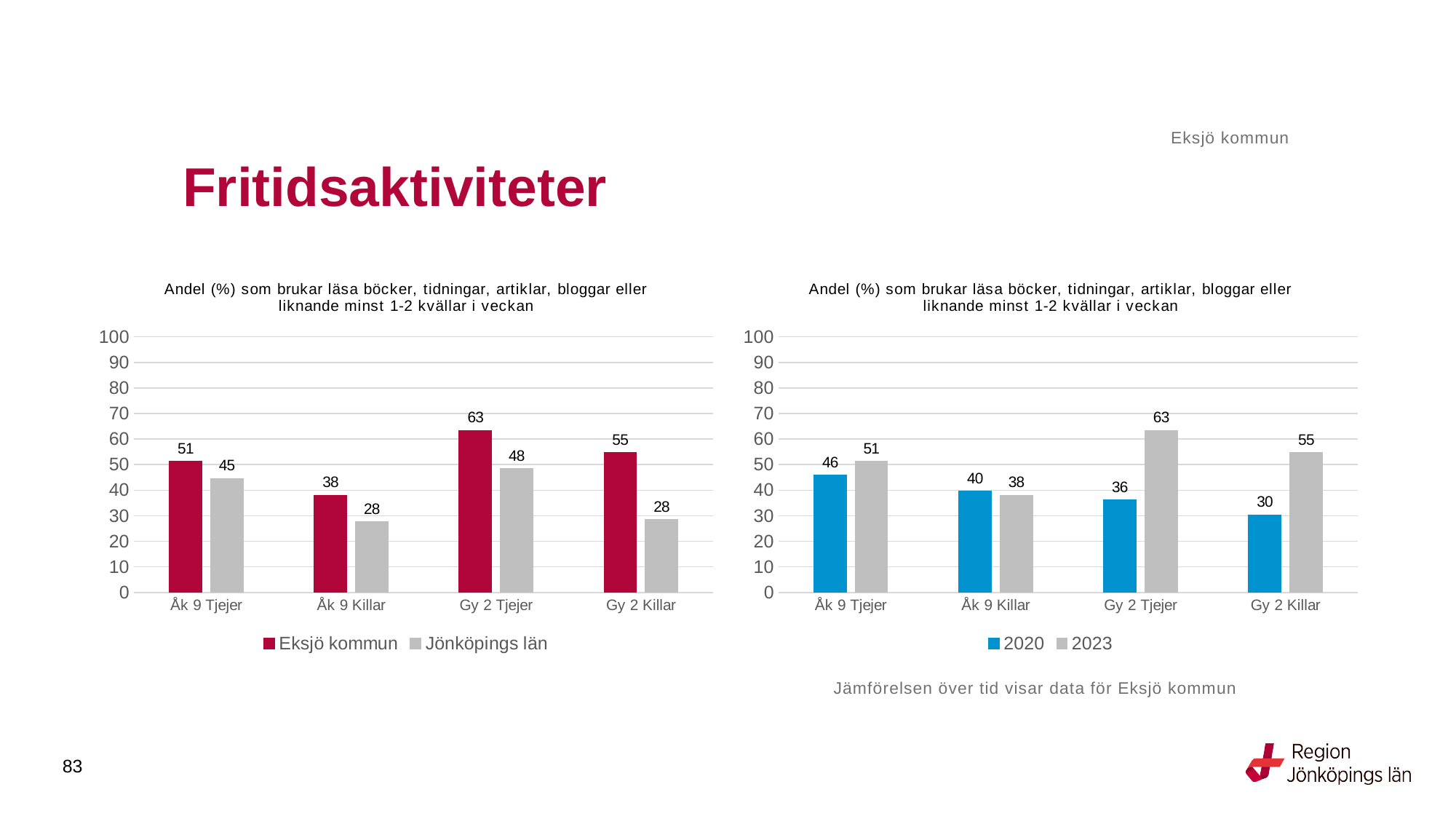
In the left chart, which category has the lowest value for Eksjö kommun? Åk 9 Killar In the left chart, what is the value for Eksjö kommun for Gy 2 Tjejer? 63 In the left chart, what is the difference between Eksjö kommun and Jönköpings län for Gy 2 Killar? 27 In the right chart, what is the difference between 2023 and 2020 for Gy 2 Tjejer? 27 In the right chart, what is the value for 2023 for Gy 2 Killar? 55 In the right chart, how many categories are shown on the x axis? 4 In the right chart, which category has the highest value for 2023? Gy 2 Tjejer In the right chart, what is the value for 2020 for Gy 2 Tjejer? 36 What kind of chart is the left chart? Bar chart In the right chart, which is larger for Åk 9 Killar: 2020 or 2023? 2020 In the left chart, how many series does the legend list? 2 In the left chart, what is the value for Jönköpings län for Åk 9 Killar? 28